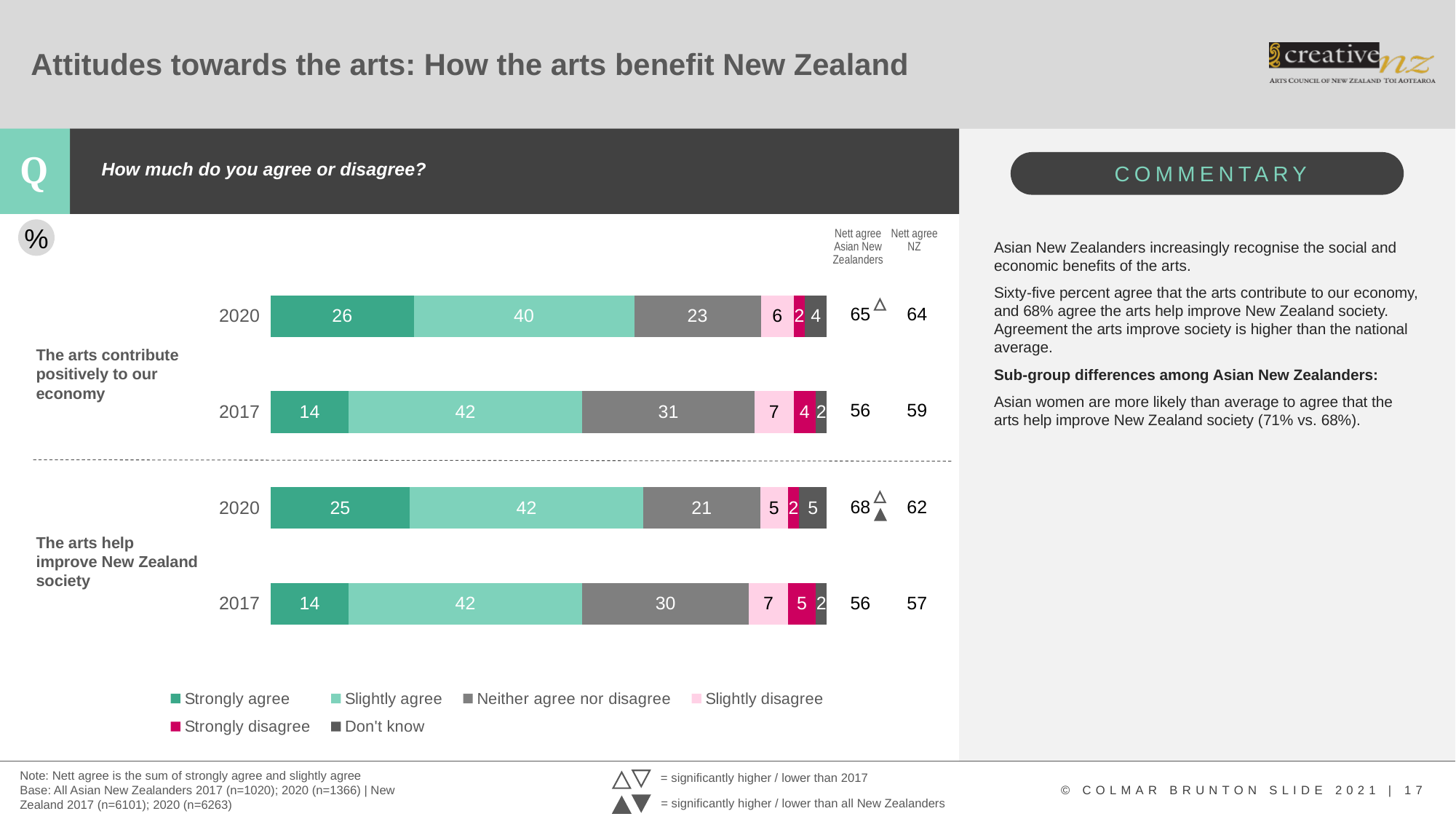
What is the 'Slightly agree' value for 'The arts help improve New Zealand society' in 2020? 42 What is the Nett agree NZ figure for 'The arts contribute positively to our economy' in 2017? 59 What type of chart is shown on the slide? Stacked bar chart What is the 'Don't know' value for 'The arts help improve New Zealand society' in 2020? 5 Which 2017 bar has the larger 'Neither agree nor disagree' value: 'The arts contribute positively to our economy' or 'The arts help improve New Zealand society'? The arts contribute positively to our economy What percentage of Asian New Zealanders strongly agreed in 2020 that the arts contribute positively to our economy? 26 What is the Nett agree figure for Asian New Zealanders in 2020 for 'The arts help improve New Zealand society'? 68 In 2017, what percentage neither agreed nor disagreed that the arts contribute positively to our economy? 31 How many bars are plotted in the chart? 4 Which bar has the highest 'Strongly agree' value? The arts contribute positively to our economy, 2020 How many series does the legend list? 6 By how many percentage points did 'Strongly agree' for 'The arts contribute positively to our economy' increase from 2017 to 2020? 12